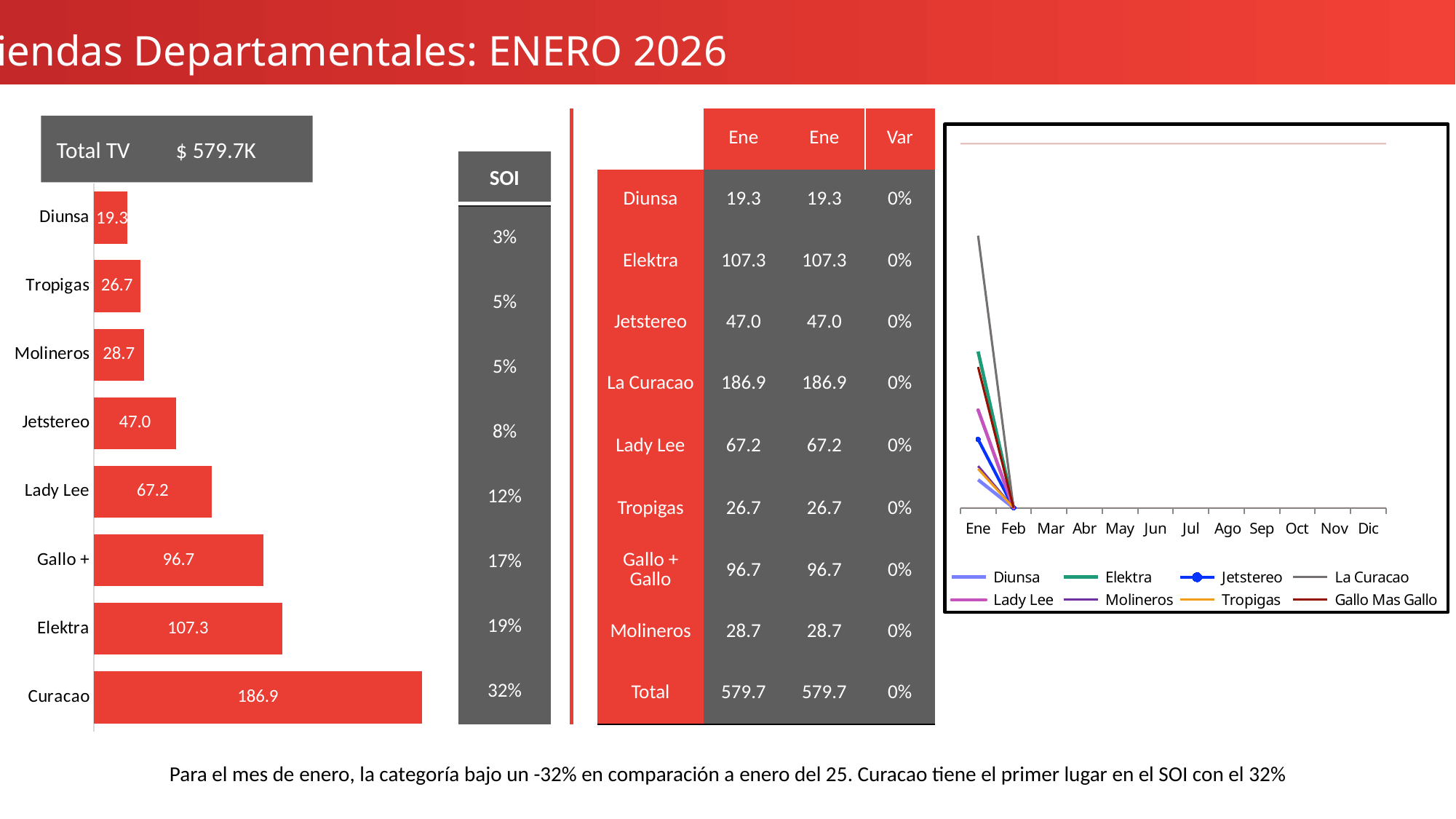
How many series does the legend of the line chart on the right list? 8 In the bar chart on the left, which is larger, the value for Jetstereo or the value for Molineros? Jetstereo In the bar chart on the left, what is the value for Lady Lee? 67.2 In the bar chart on the left, what is the difference between the values for Curacao and Elektra? 79.6 How many categories are shown in the bar chart on the left? 8 In the bar chart on the left, what is the difference between the values for Gallo + and Tropigas? 70.0 In the bar chart on the left, which category has the highest value? Curacao In the bar chart on the left, which category has the lowest value? Diunsa What kind of chart is the chart on the right of the slide? Line chart In the bar chart on the left, what is the value for Elektra? 107.3 How many months are labelled on the x axis of the line chart on the right? 12 What kind of chart is the chart on the left of the slide? Bar chart